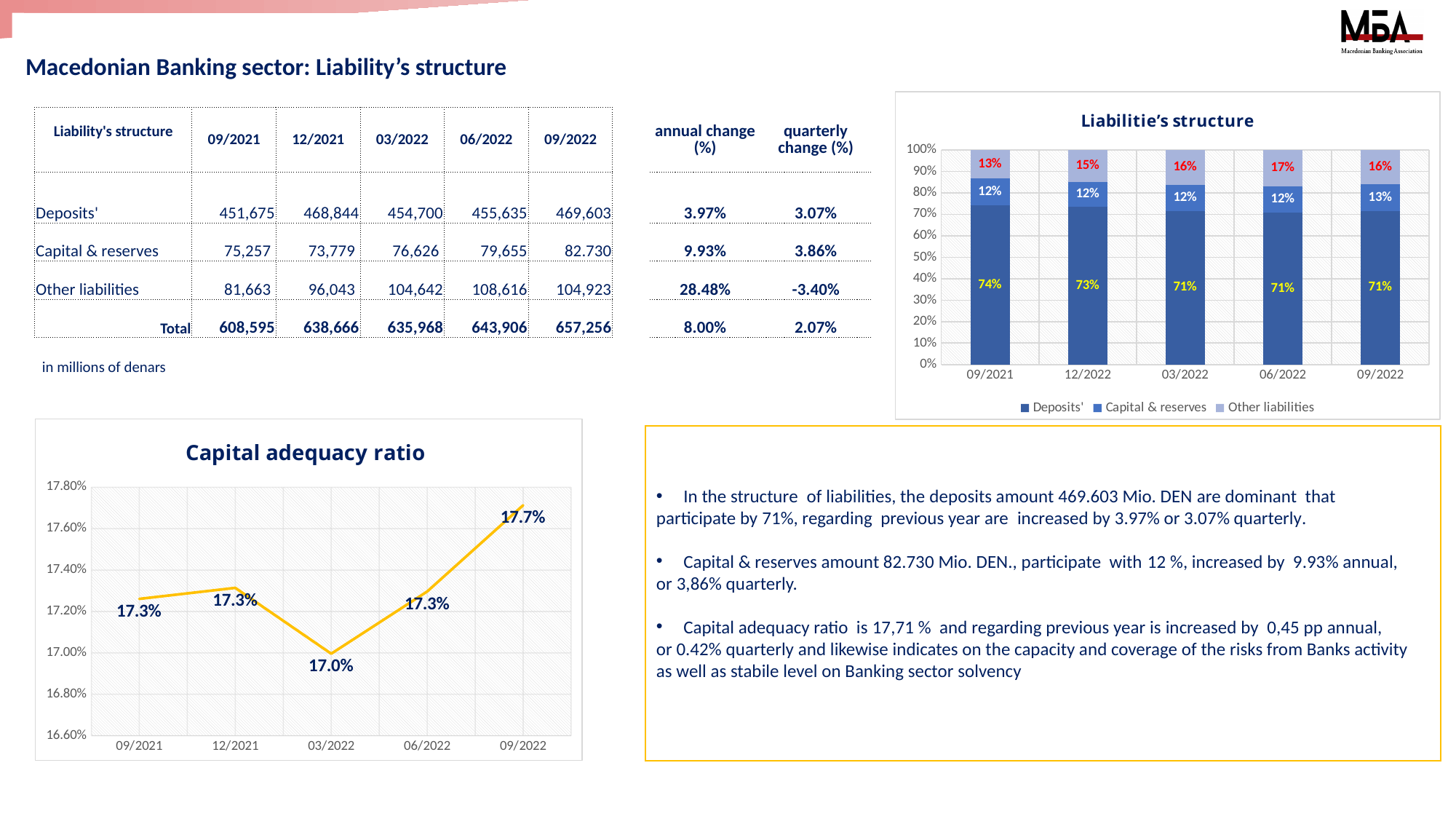
In the 'Liabilitie's structure' chart, which period has the highest Deposits' share? 09/2021 In the 'Capital adequacy ratio' chart, which period has the highest value? 09/2022 In the 'Capital adequacy ratio' chart, what is the value for 03/2022? 17.0% In the 'Capital adequacy ratio' chart, how many data points are plotted? 5 In the 'Liabilitie's structure' chart, what is the Deposits' share for 09/2021? 74% In the 'Liabilitie's structure' chart, what is the difference between the Deposits' share for 09/2021 and for 09/2022? 3% In the 'Liabilitie's structure' chart, which period has the lowest Other liabilities share? 09/2021 What kind of chart is the 'Liabilitie's structure' chart? Stacked bar chart In the 'Liabilitie's structure' chart, what is the Other liabilities share for 06/2022? 17% In the 'Liabilitie's structure' chart, what is the Capital & reserves share for 09/2022? 13% What kind of chart is the 'Capital adequacy ratio' chart? Line chart In the 'Liabilitie's structure' chart, how many series does the legend list? 3